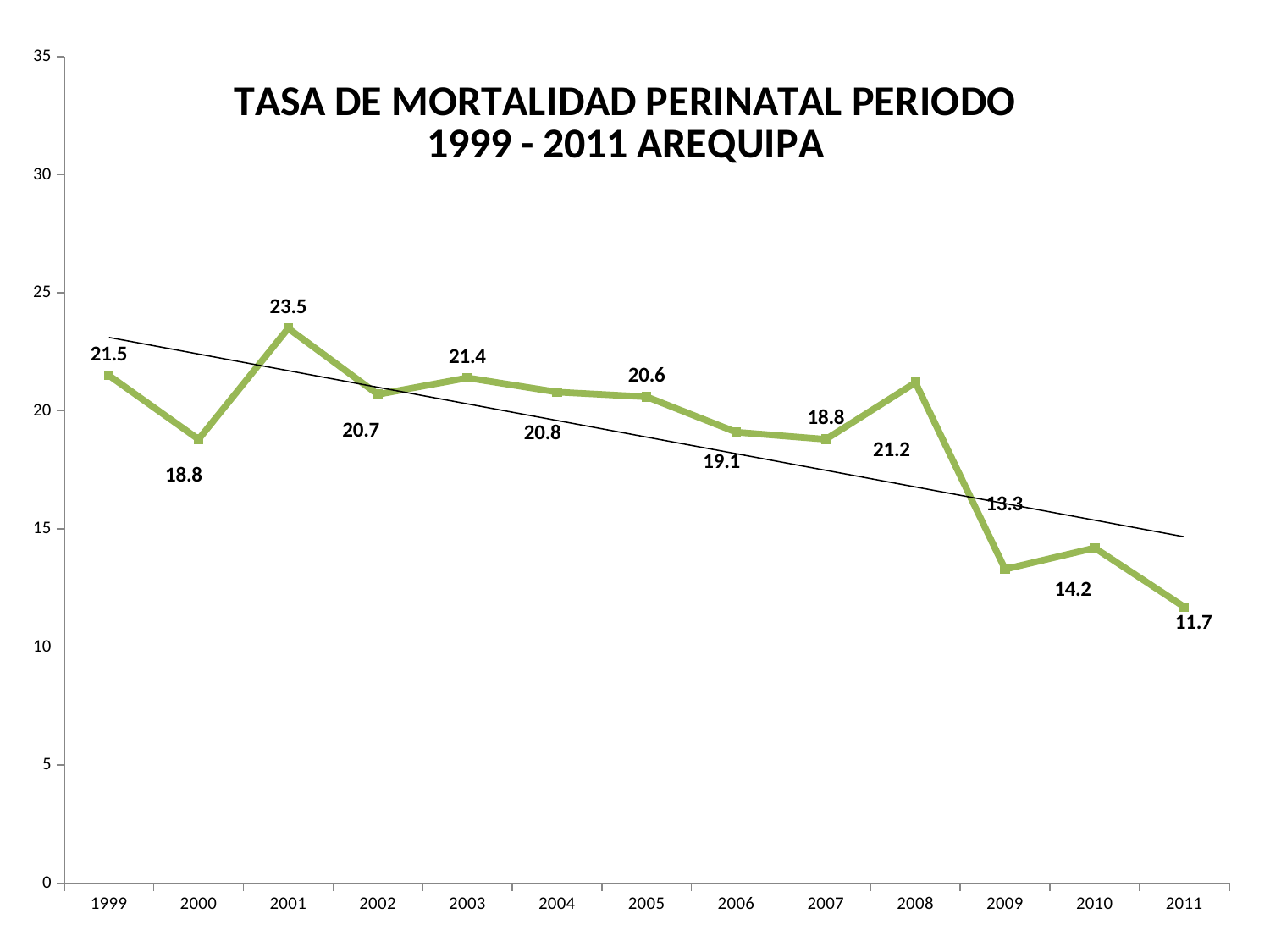
Which is larger, the value for 2009 or the value for 2010? 2010 What is the value shown for 2005? 20.6 Do the values generally rise or fall from 1999 to 2011? Fall What is the perinatal mortality rate for 2011? 11.7 What is the title of the chart? TASA DE MORTALIDAD PERINATAL PERIODO 1999 - 2011 AREQUIPA What is the difference between the rate in 2001 and the rate in 2011? 11.8 What type of chart is shown on the slide? Line chart Which year has the lowest perinatal mortality rate? 2011 Which year has the highest perinatal mortality rate? 2001 What is the perinatal mortality rate for 2001? 23.5 Is the value for 2008 greater or less than 20? greater How many years are plotted on the chart? 13